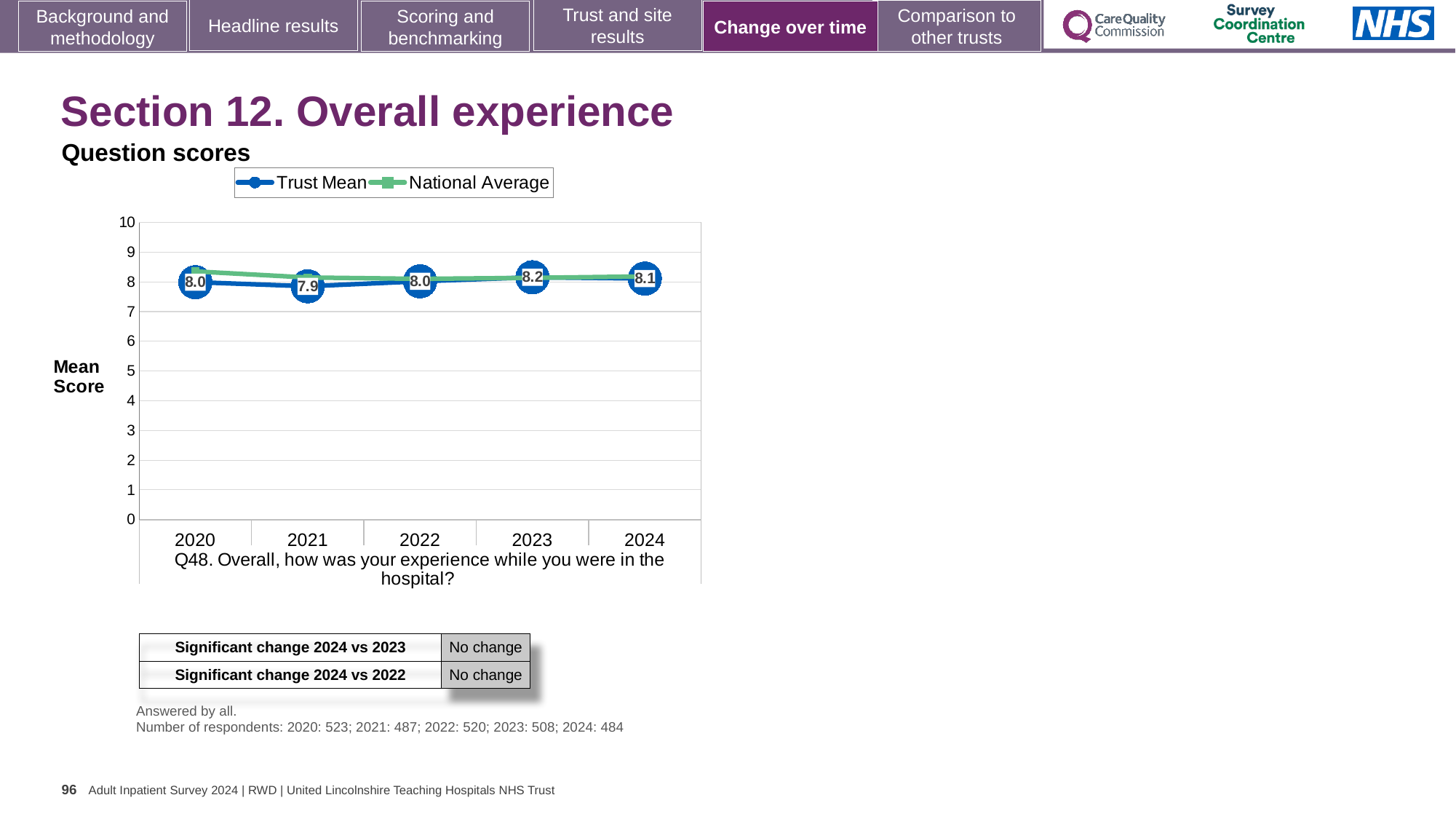
Does the Trust Mean score rise or fall from 2021 to 2023? Rise What is the difference between the Trust Mean scores for 2023 and 2021? 0.3 What kind of chart is shown on the slide? Line chart Which year has the larger Trust Mean score, 2021 or 2024? 2024 How many series does the legend list? 2 In which year is the Trust Mean score lowest? 2021 Is the National Average value for 2020 greater or less than 5? greater In which year is the Trust Mean score highest? 2023 What is the Trust Mean score for 2021? 7.9 How many years are plotted on the x axis? 5 What is the Trust Mean score for 2023? 8.2 What is the Trust Mean score for 2024? 8.1